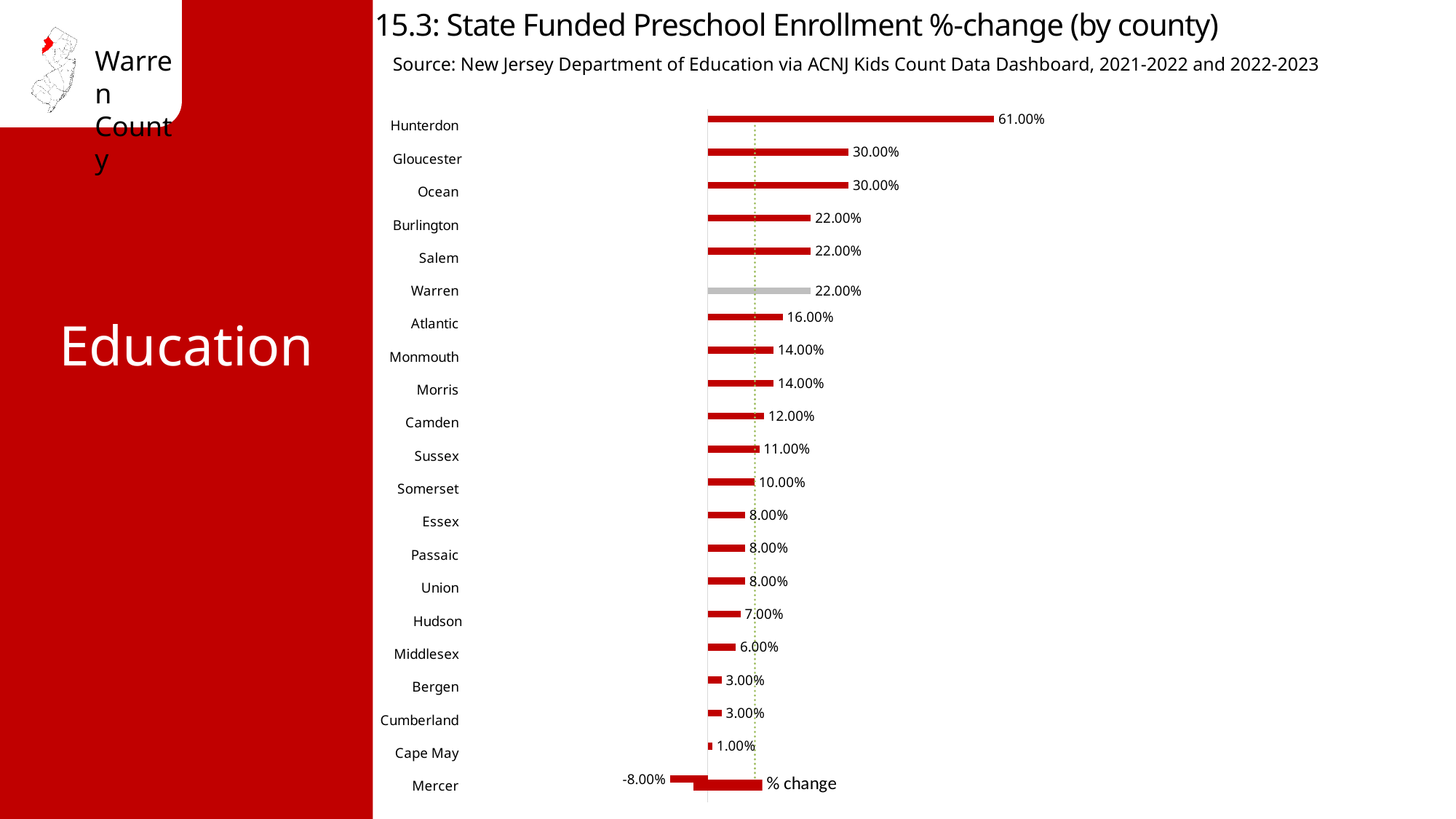
What is the %-change value shown for Hunterdon? 61.00% How many series does the legend list? 1 What is the state funded preschool enrollment %-change for Warren? 22.00% Which county has the lowest state funded preschool enrollment %-change? Mercer Which county has the highest state funded preschool enrollment %-change? Hunterdon How many counties are shown in the chart? 21 Which has a larger %-change, Atlantic or Camden? Atlantic What is the %-change value shown for Cape May? 1.00% What kind of chart is shown on the slide? Bar chart What is the difference between the %-change for Hunterdon and the %-change for Gloucester? 31.00% What is the %-change value shown for Mercer? -8.00% What is the legend entry for the series in the chart? % change